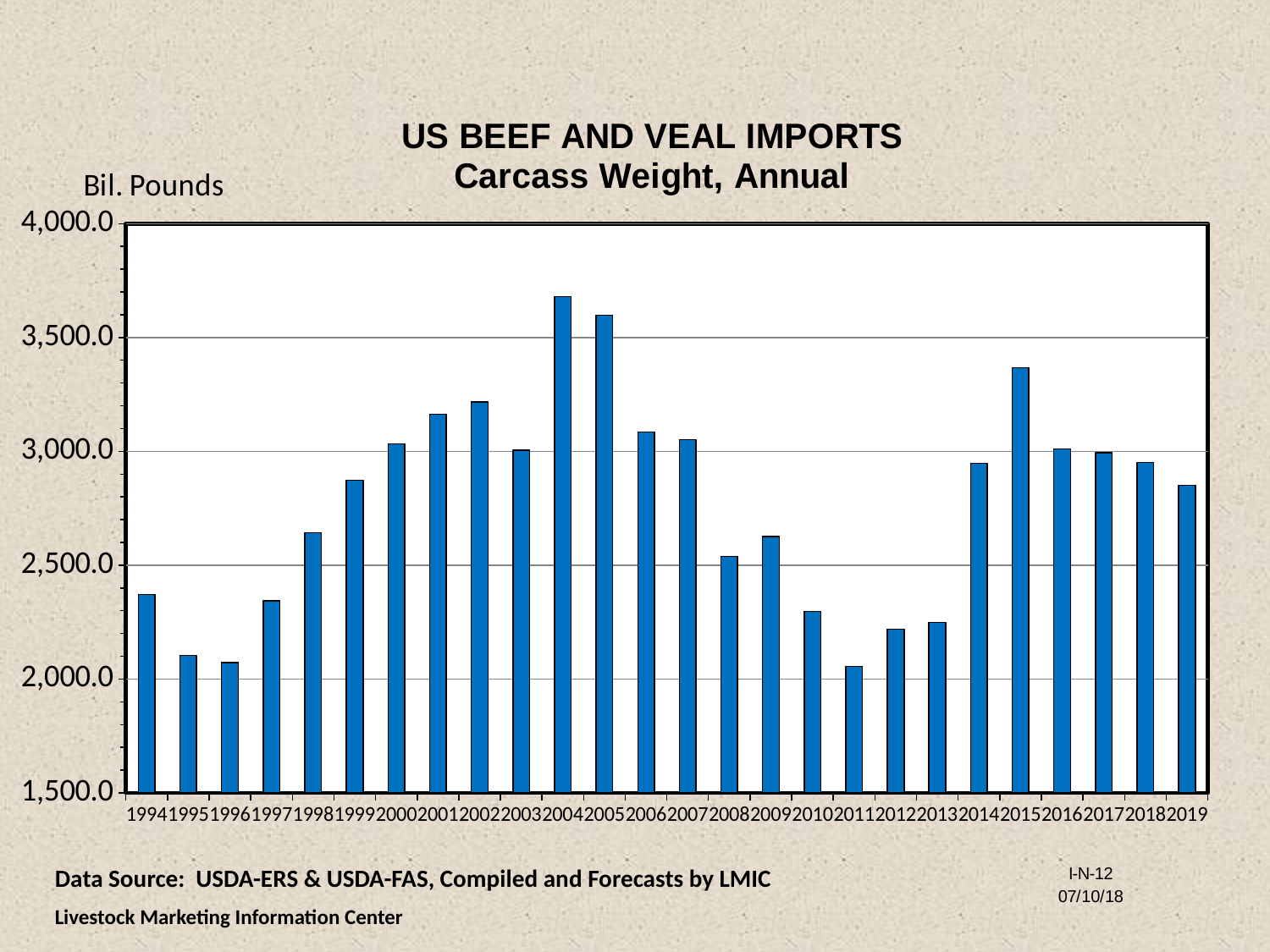
Is the value for 2011 greater or less than 2,500.0? less Which year has the larger value, 1997 or 1998? 1998 What unit is shown on the y axis label? Bil. Pounds Which year has the larger value, 2014 or 2015? 2015 Is the value for 2015 greater or less than 3,000.0? greater What kind of chart is shown on the slide? bar chart Is the value for 2019 greater or less than 3,000.0? less Do the values rise or fall from 2011 to 2015? rise How many years are plotted on the x axis? 26 Which year has the highest US beef and veal imports? 2004